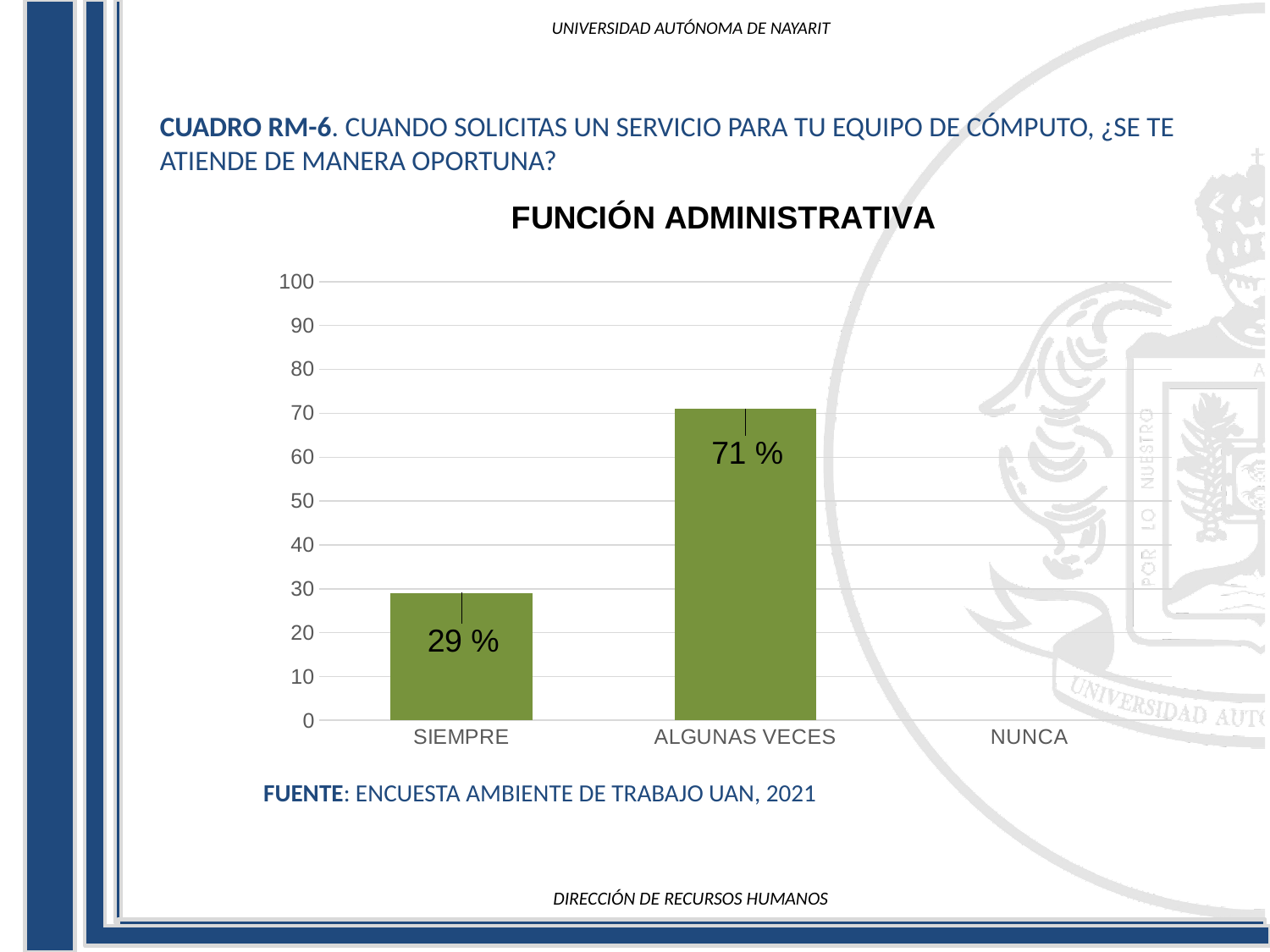
Which category has the highest value? ALGUNAS VECES Is the value for ALGUNAS VECES greater or less than 60? greater How many categories are shown on the x axis? 3 What is the highest value shown on the y axis? 100 Is the value for SIEMPRE greater or less than 40? less What is the value for SIEMPRE? 29 % What is the title of the chart? FUNCIÓN ADMINISTRATIVA What kind of chart is shown? bar chart What is the value for ALGUNAS VECES? 71 % Which is larger, the value for SIEMPRE or the value for ALGUNAS VECES? ALGUNAS VECES What is the difference between the values for ALGUNAS VECES and SIEMPRE? 42 %